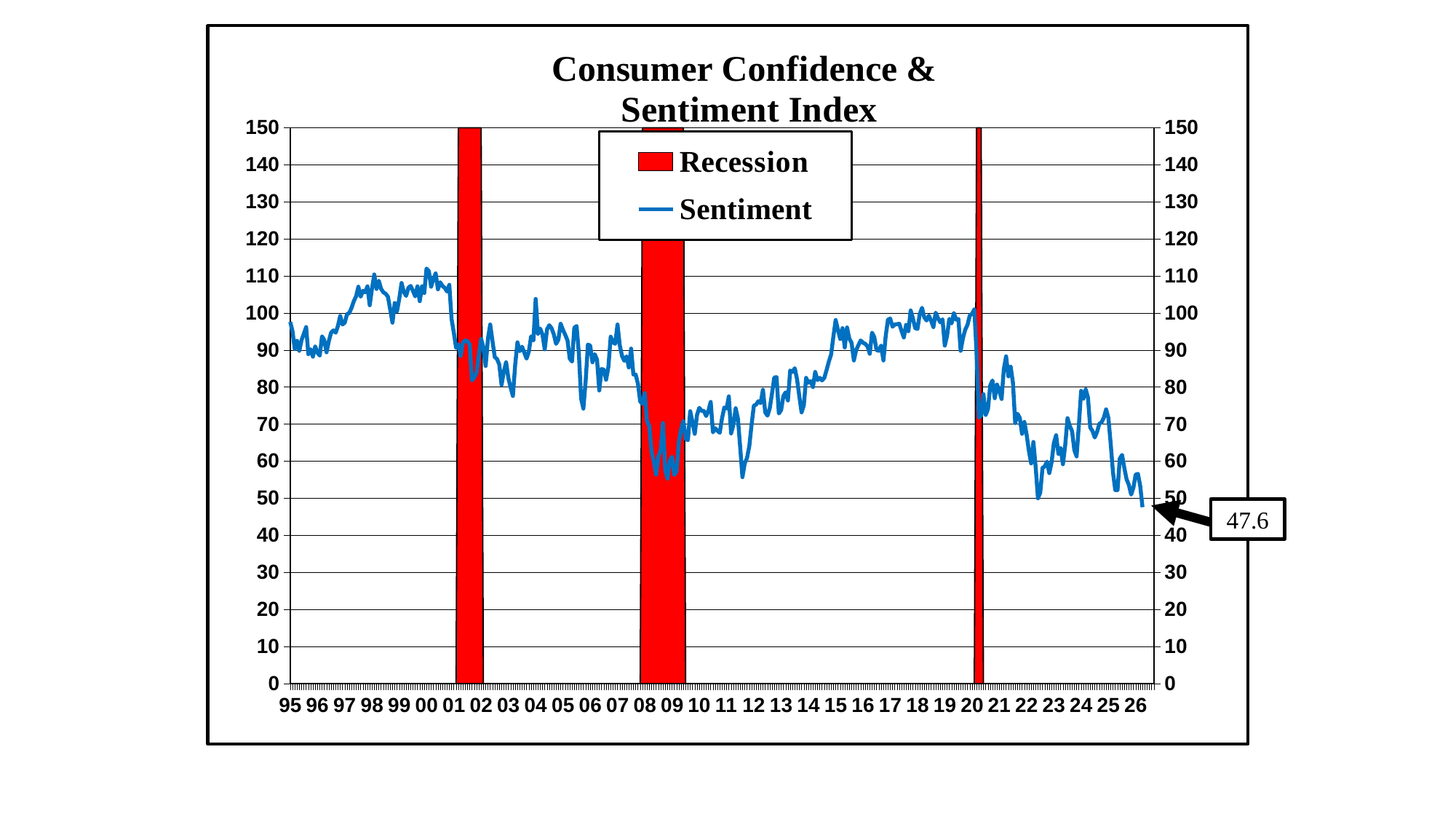
Does the Sentiment line rise or fall from 2009 to 2018? rise Is the Sentiment value in 2000 greater or less than 100? greater What is the title of the chart? Consumer Confidence & Sentiment Index How many entries does the legend list? 2 Which is higher, the Sentiment value in 2000 or in 2009? 2000 How many recession periods are shaded on the chart? 3 What is the most recent Sentiment value labelled on the chart? 47.6 Does the Sentiment line rise or fall from 2021 to 2026? fall Is the lowest Sentiment value during the 2008-09 recession greater or less than 60? less What is the maximum value shown on the vertical axis? 150 Is the Sentiment value in 2018 greater or less than 90? greater What kind of chart is shown on the slide? line chart